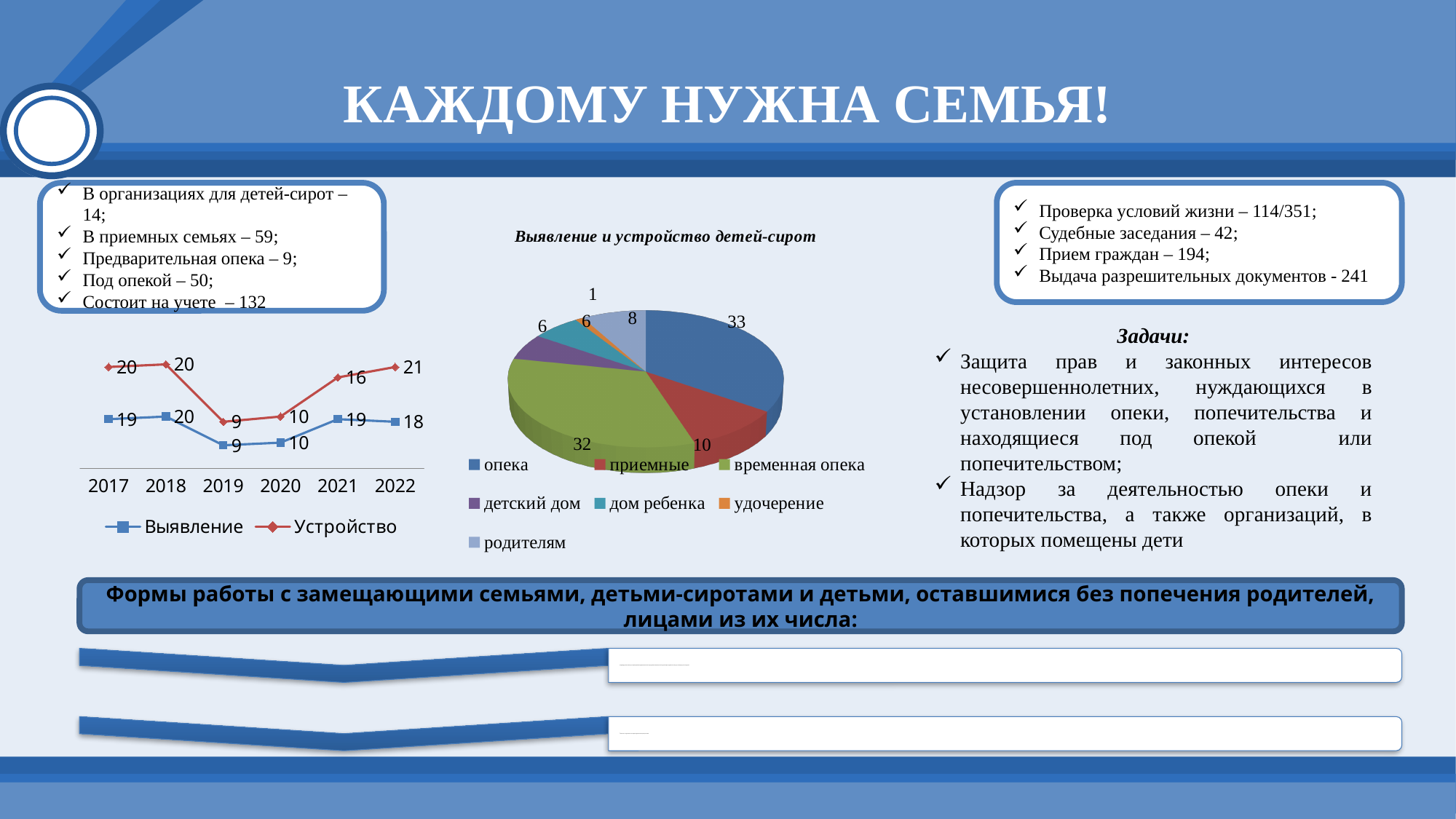
In the pie chart titled 'Выявление и устройство детей-сирот', which category has the smallest value? удочерение In the pie chart titled 'Выявление и устройство детей-сирот', what is the value for временная опека? 32 In the line chart on the left, which year has the highest value for Устройство? 2022 In the line chart on the left, which is larger in 2022: Выявление or Устройство? Устройство What type of chart is the one titled 'Выявление и устройство детей-сирот'? pie chart In the line chart on the left, what is the difference between Устройство and Выявление in 2021? 3 In the line chart on the left, which year has the lowest value for Выявление? 2019 In the line chart on the left, how many years are shown on the x axis? 6 In the line chart on the left, what is the value of Выявление for 2019? 9 In the pie chart titled 'Выявление и устройство детей-сирот', how many categories does the legend list? 7 In the line chart on the left, how many series does the legend list? 2 In the line chart on the left, what is the value of Устройство for 2022? 21